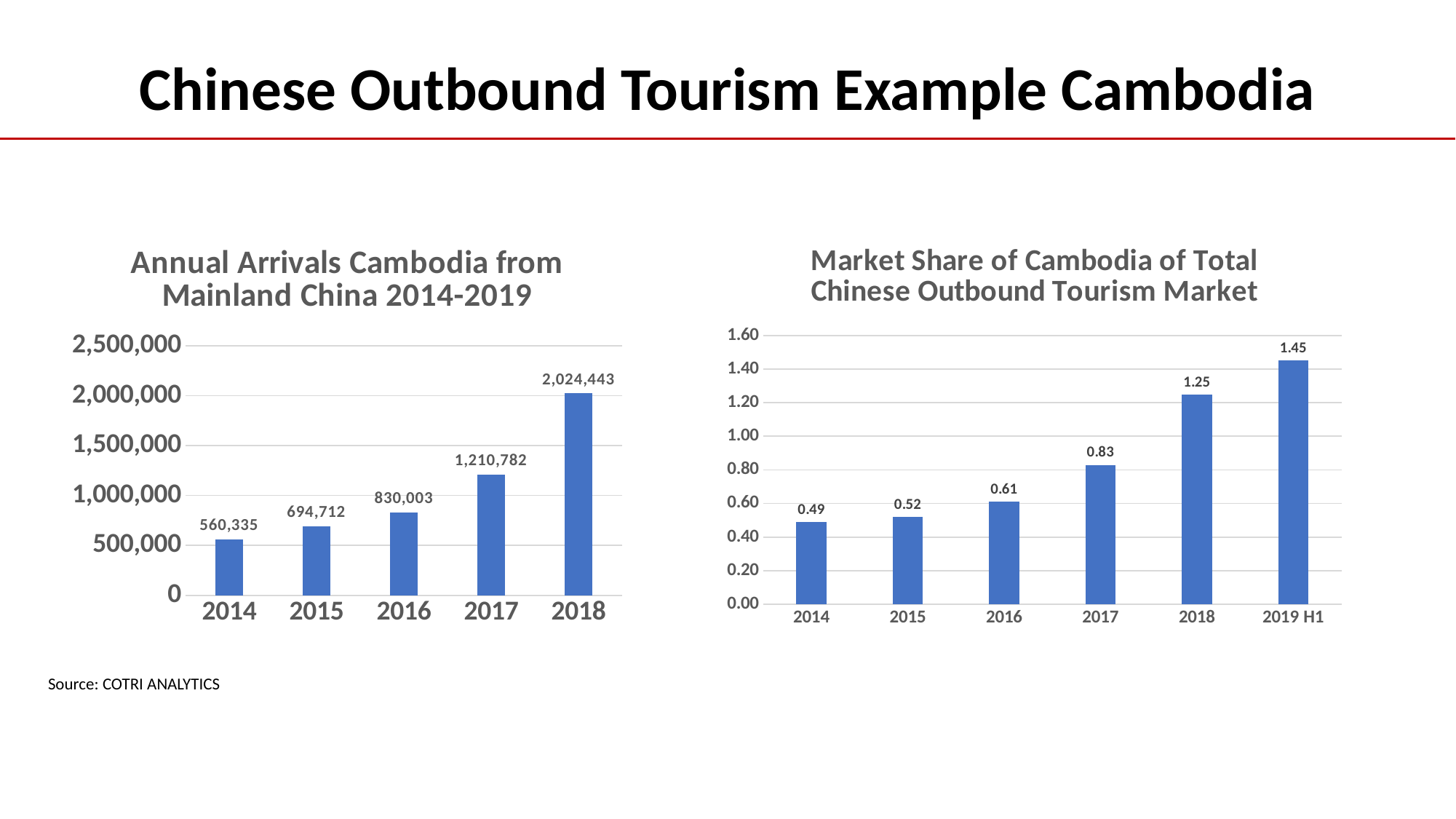
In the 'Annual Arrivals Cambodia from Mainland China 2014-2019' chart, do the values rise or fall from 2014 to 2018? rise In the 'Annual Arrivals Cambodia from Mainland China 2014-2019' chart, what is the difference between the 2018 and 2017 values? 813,661 In the 'Market Share of Cambodia of Total Chinese Outbound Tourism Market' chart, what is the value for 2019 H1? 1.45 In the 'Market Share of Cambodia of Total Chinese Outbound Tourism Market' chart, how many bars are shown? 6 In the 'Market Share of Cambodia of Total Chinese Outbound Tourism Market' chart, which is larger, the value for 2015 or the value for 2016? 2016 In the 'Market Share of Cambodia of Total Chinese Outbound Tourism Market' chart, what is the difference between the 2018 and 2014 values? 0.76 What kind of chart is the 'Market Share of Cambodia of Total Chinese Outbound Tourism Market' chart? bar chart In the 'Annual Arrivals Cambodia from Mainland China 2014-2019' chart, what is the value for 2016? 830,003 In the 'Annual Arrivals Cambodia from Mainland China 2014-2019' chart, which year has the highest value? 2018 In the 'Annual Arrivals Cambodia from Mainland China 2014-2019' chart, how many years are shown on the x axis? 5 In the 'Annual Arrivals Cambodia from Mainland China 2014-2019' chart, which year has the lowest value? 2014 In the 'Market Share of Cambodia of Total Chinese Outbound Tourism Market' chart, what is the value for 2017? 0.83